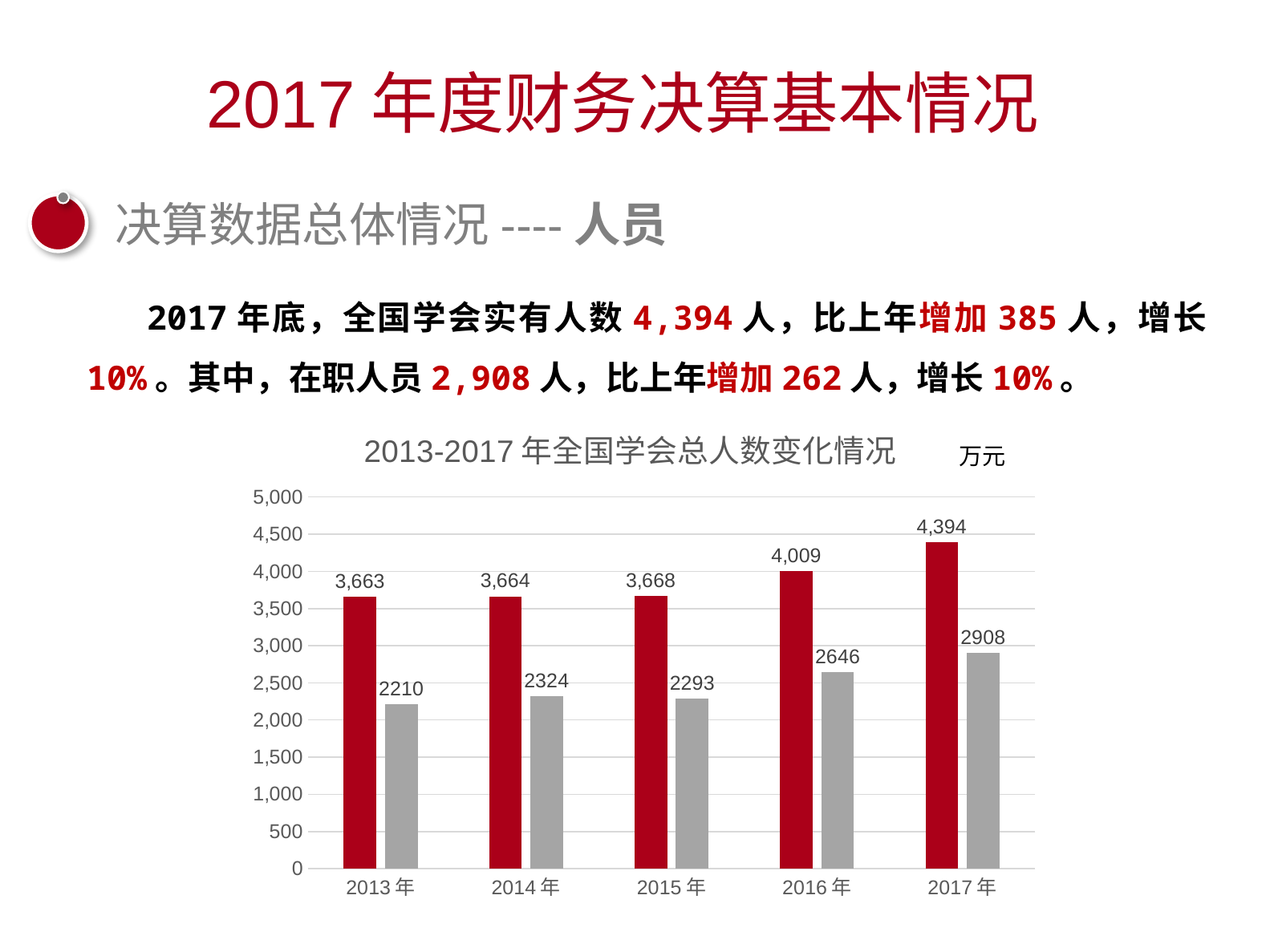
What kind of chart is shown on the slide? bar chart What is the value of the red bar for 2013 年? 3,663 Which year has the highest red bar? 2017 年 How many years are shown on the x axis of the chart? 5 Which is larger, the grey bar for 2014 年 or the grey bar for 2015 年? 2014 年 What is the value of the grey bar for 2016 年? 2646 Is the value of the grey bar for 2017 年 greater or less than 3,000? less Do the red bars rise or fall from 2013 年 to 2017 年? rise What is the difference between the grey bar values for 2017 年 and 2016 年? 262 What is the difference between the red bar values for 2017 年 and 2016 年? 385 Which year has the lowest grey bar? 2013 年 What is the value of the red bar for 2017 年? 4,394